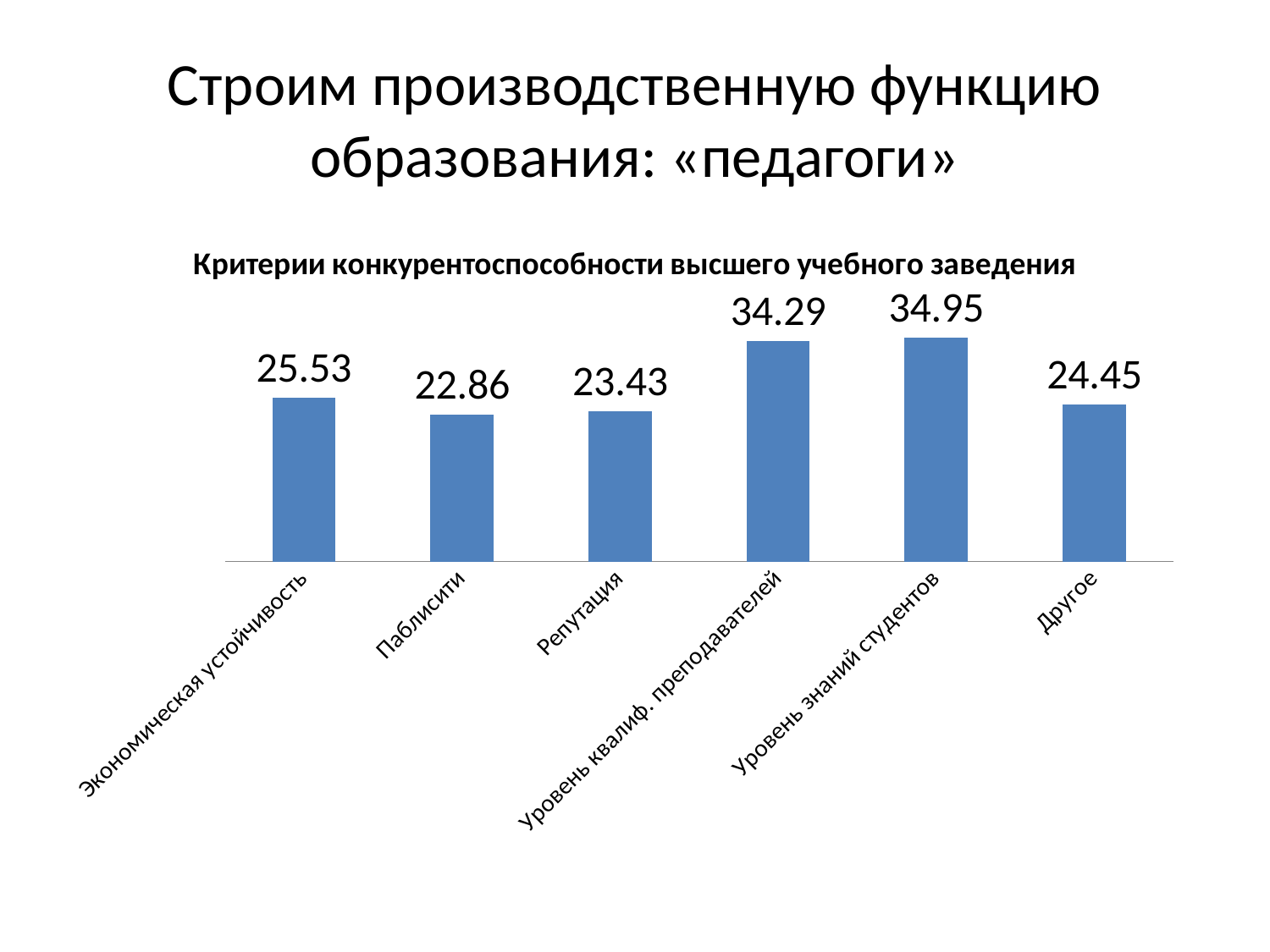
What is the value for Уровень знаний студентов? 34.95 What is the difference between the values for Экономическая устойчивость and Паблисити? 2.67 What is the value for Другое? 24.45 What is the difference between the values for Уровень знаний студентов and Уровень квалиф. преподавателей? 0.66 What is the value for Паблисити? 22.86 How many categories are shown in the chart? 6 Which category has the highest value? Уровень знаний студентов What is the value for Экономическая устойчивость? 25.53 Which category has the lowest value? Паблисити Which is larger, the value for Репутация or the value for Другое? Другое What kind of chart is shown on the slide? Bar chart What is the title of the chart? Критерии конкурентоспособности высшего учебного заведения